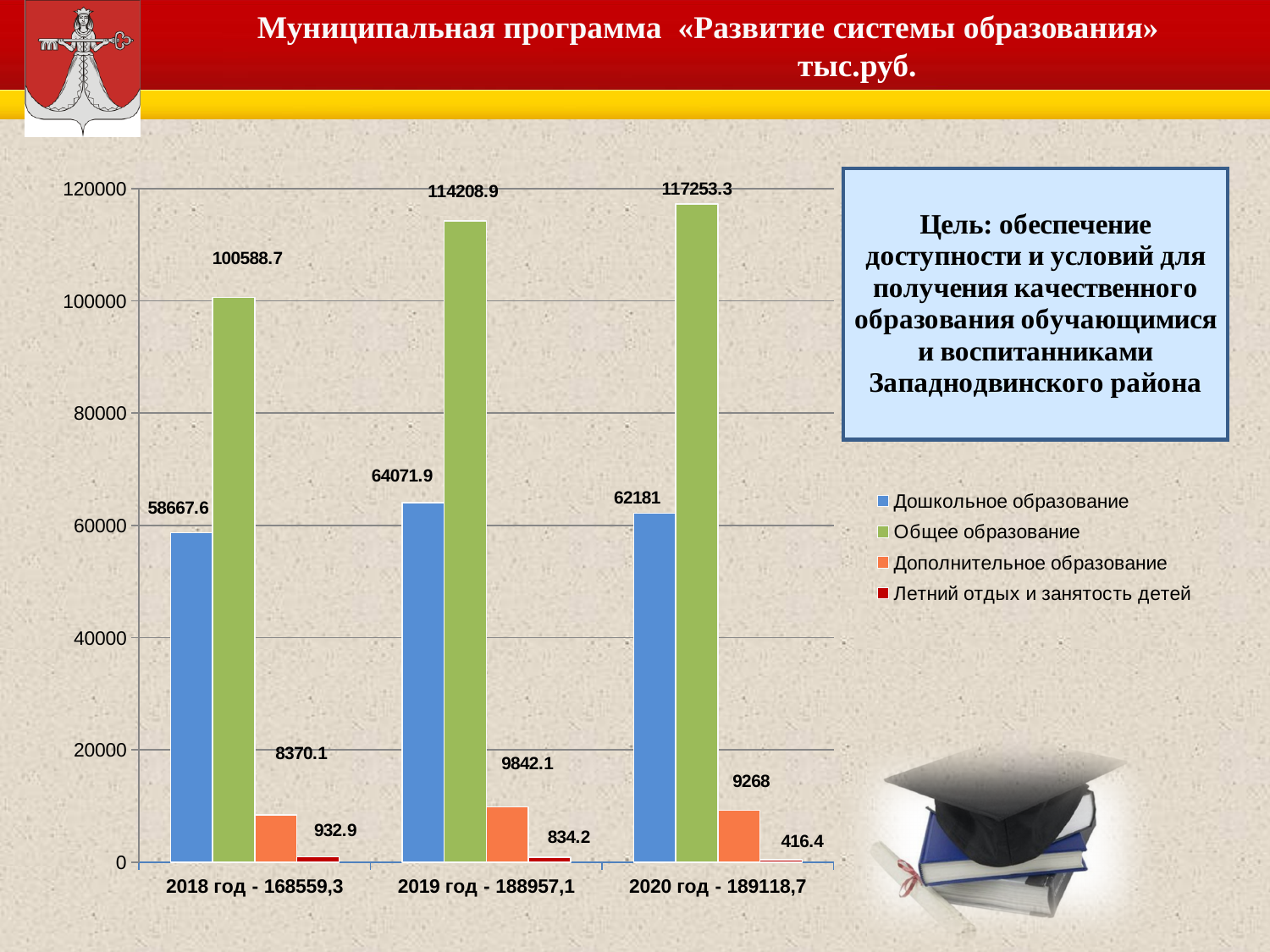
In which year is the value for Общее образование the highest? 2020 год What is the value for Дополнительное образование in 2018 год? 8370.1 What is the value for Летний отдых и занятость детей in 2019 год? 834.2 Which is larger: Дошкольное образование in 2019 год or in 2020 год? 2019 год What is the value for Дошкольное образование in 2020 год? 62181 Is the value for Общее образование in 2018 год greater or less than 100000? greater What is the difference between the Общее образование values for 2020 год and 2019 год? 3044.4 In which year is the value for Летний отдых и занятость детей the lowest? 2020 год What is the value for Общее образование in 2019 год? 114208.9 How many series does the legend list? 4 Do the values for Общее образование rise or fall from 2018 год to 2020 год? Rise What kind of chart is shown on the slide? Bar chart